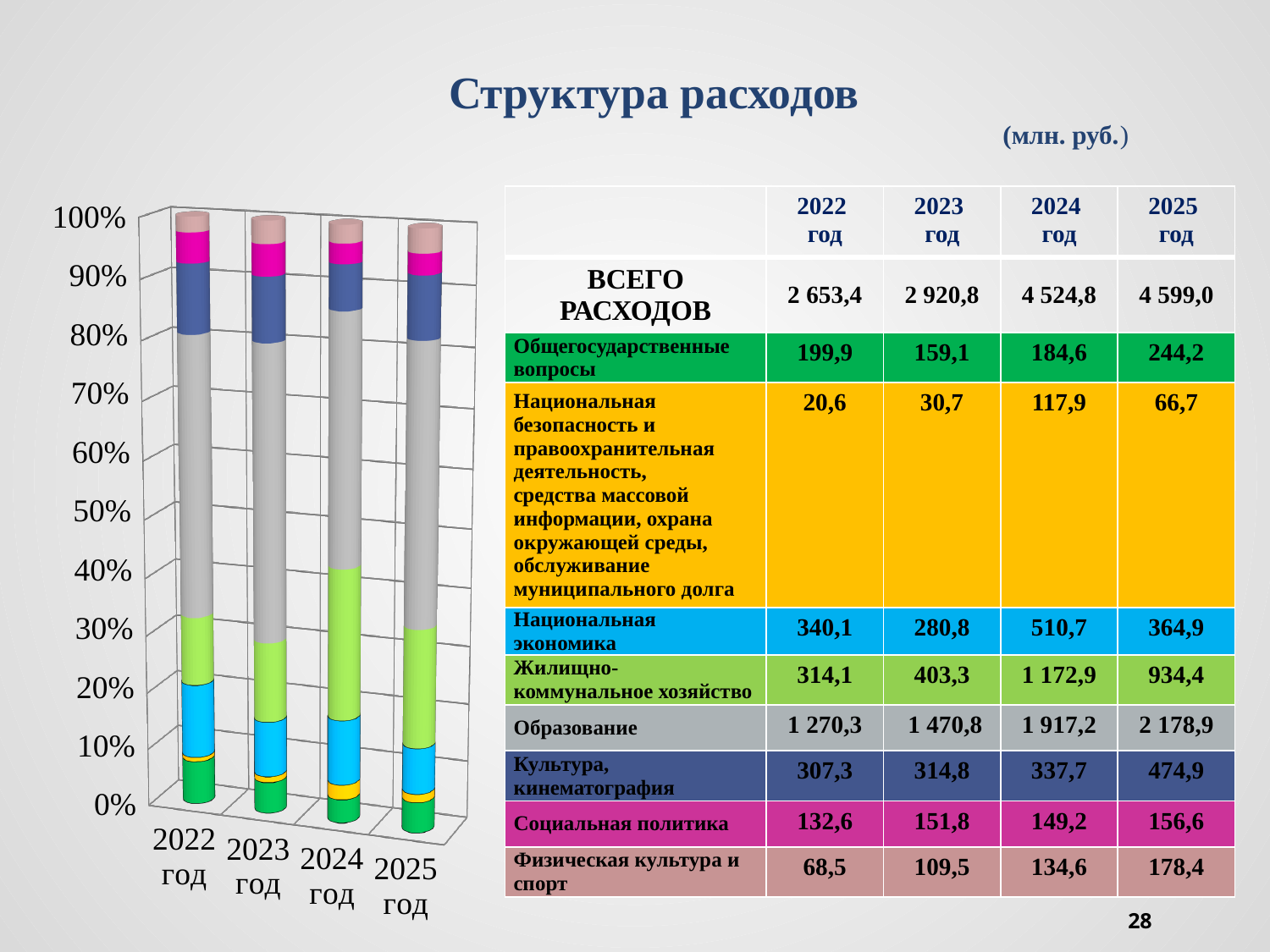
How many years (categories) are plotted on the x axis of the chart? 4 What is the title of the slide's chart/table? Структура расходов What is the difference between Жилищно-коммунальное хозяйство in 2024 год and 2025 год? 238,5 What is the value for Образование in 2025 год? 2 178,9 What is the value for Национальная экономика in 2022 год? 340,1 What unit is stated for the values on the slide? млн. руб. What kind of chart is shown on the slide? Stacked bar chart Does the value for Образование rise or fall from 2022 год to 2025 год? Rise What is the value of ВСЕГО РАСХОДОВ for 2024 год? 4 524,8 Which is larger in 2024 год: Социальная политика or Физическая культура и спорт? Социальная политика Which expenditure category has the smallest value in 2022 год? Национальная безопасность и правоохранительная деятельность, средства массовой информации, охрана окружающей среды, обслуживание муниципального долга Which expenditure category has the largest value in 2023 год? Образование